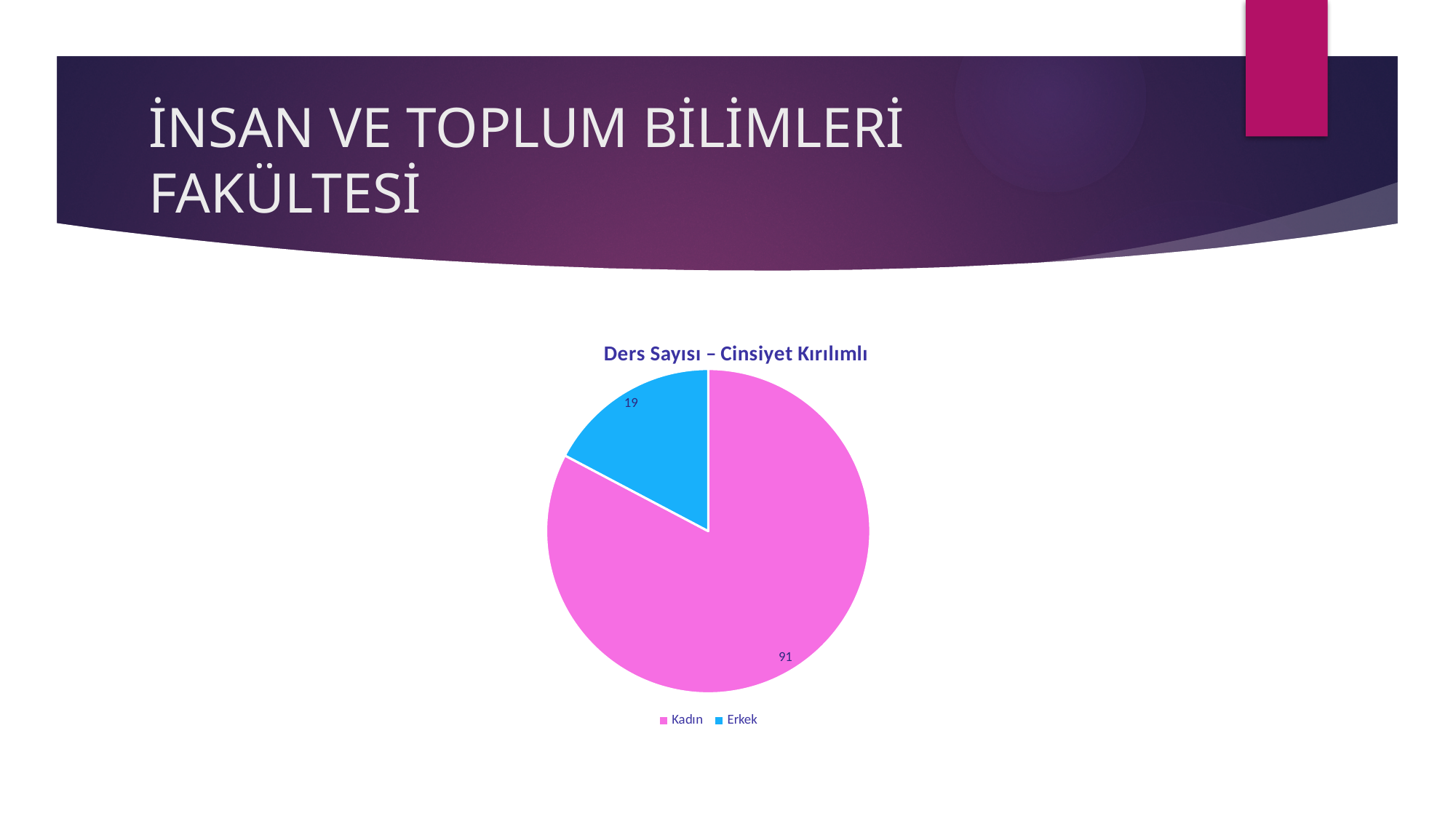
What is the total of the two slices in the pie chart? 110 What kind of chart is shown on the slide? Pie chart Which is larger, the value for Kadın or the value for Erkek? Kadın What is the value for Erkek in the pie chart? 19 What is the value for Kadın in the pie chart? 91 How many categories does the pie chart show? 2 What is the difference between the Kadın and Erkek values? 72 Which category has the largest slice in the pie chart? Kadın What colour is the Erkek slice in the pie chart? Blue What is the title of the chart? Ders Sayısı – Cinsiyet Kırılımlı Which category has the smallest slice in the pie chart? Erkek